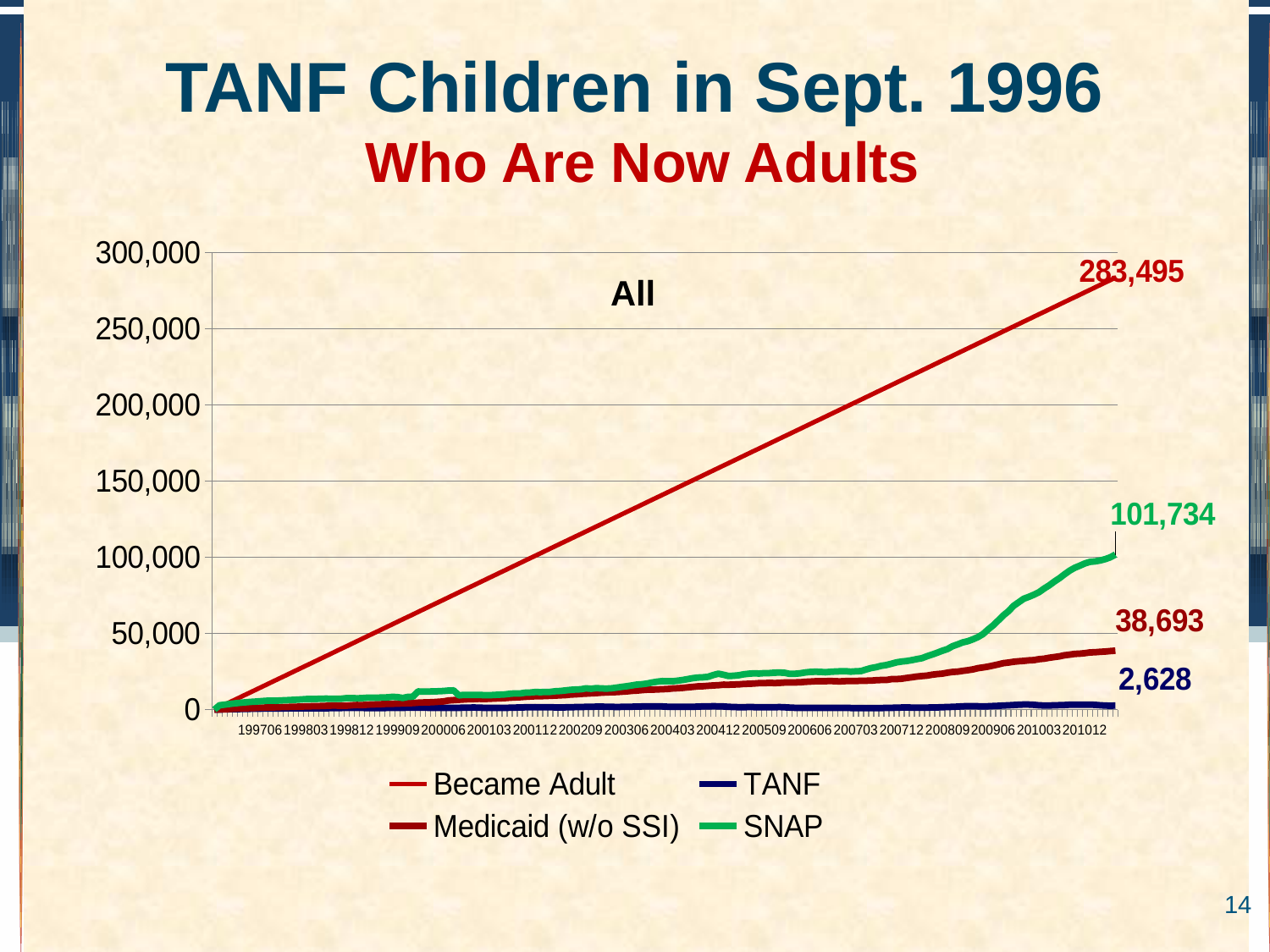
What is the final value shown for the Became Adult series? 283,495 What is the difference between the final SNAP value and the final Medicaid (w/o SSI) value? 63,041 What kind of chart is shown on the slide? Line chart What is the difference between the final Became Adult value and the final SNAP value? 181,761 Which is larger at the end of the chart, SNAP or Medicaid (w/o SSI)? SNAP How many series does the legend list? 4 Does the Became Adult series rise or fall over time along the x axis? Rise What is the final value shown for the TANF series? 2,628 Which series has the highest value at the end of the chart? Became Adult Which series has the lowest value at the end of the chart? TANF What is the final value shown for the SNAP series? 101,734 What is the final value shown for the Medicaid (w/o SSI) series? 38,693